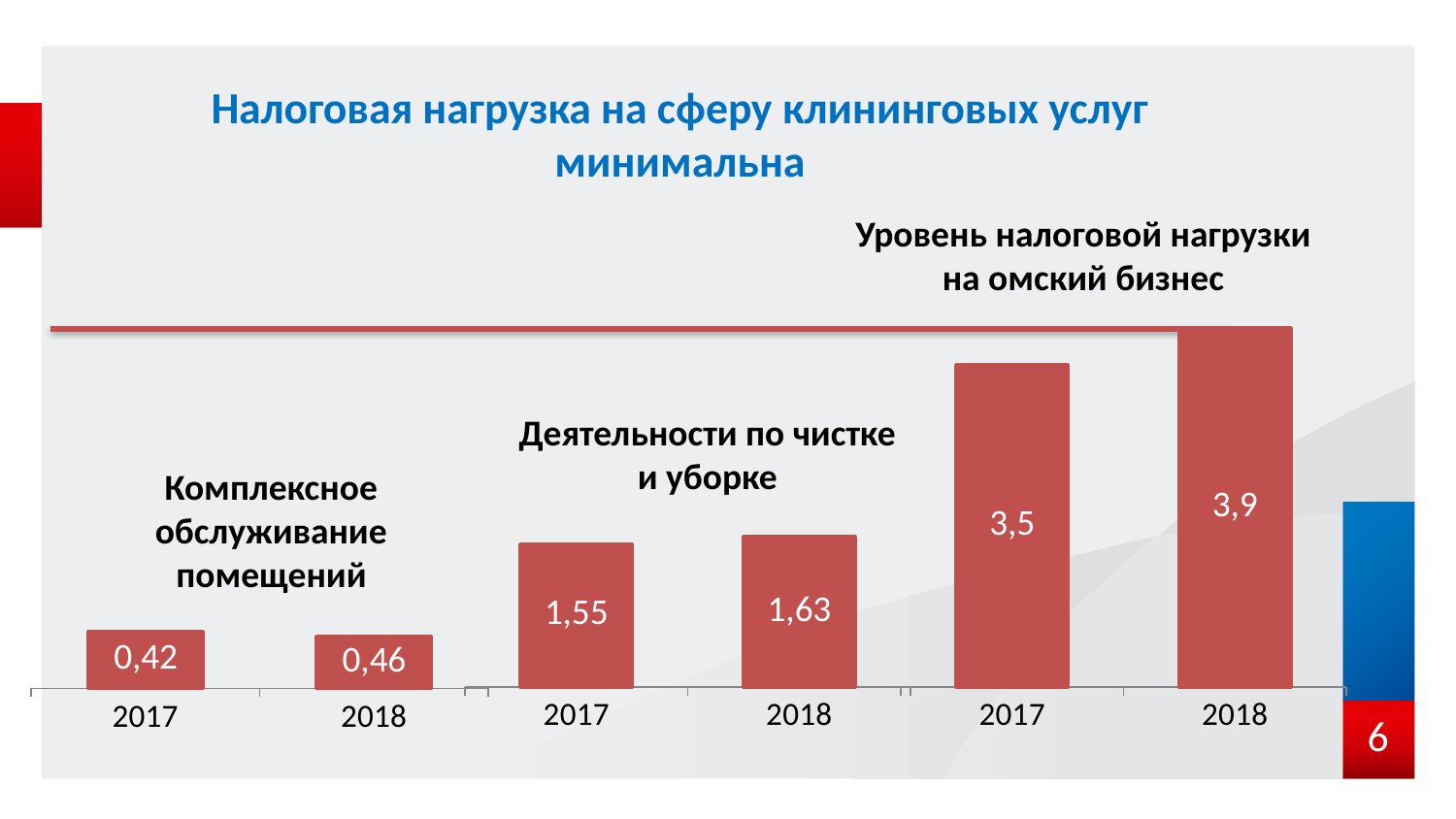
Which is larger: the 2017 value for "Деятельности по чистке и уборке" or the 2018 value for "Комплексное обслуживание помещений"? 2017 value for Деятельности по чистке и уборке What is the value for 2017 in the group "Комплексное обслуживание помещений"? 0,42 What is the difference between the 2018 and 2017 values for "Уровень налоговой нагрузки на омский бизнес"? 0,4 What is the difference between the 2018 and 2017 values for "Деятельности по чистке и уборке"? 0,08 How many bars are plotted on the chart? 6 What is the title of the slide? Налоговая нагрузка на сферу клининговых услуг минимальна What kind of chart is shown on the slide? Bar chart What is the value for 2018 in the group "Деятельности по чистке и уборке"? 1,63 Within each group, do the values rise or fall from 2017 to 2018? Rise What is the value for 2018 in the group "Уровень налоговой нагрузки на омский бизнес"? 3,9 Which bar has the lowest value on the chart? 2017, Комплексное обслуживание помещений Which bar has the highest value on the chart? 2018, Уровень налоговой нагрузки на омский бизнес